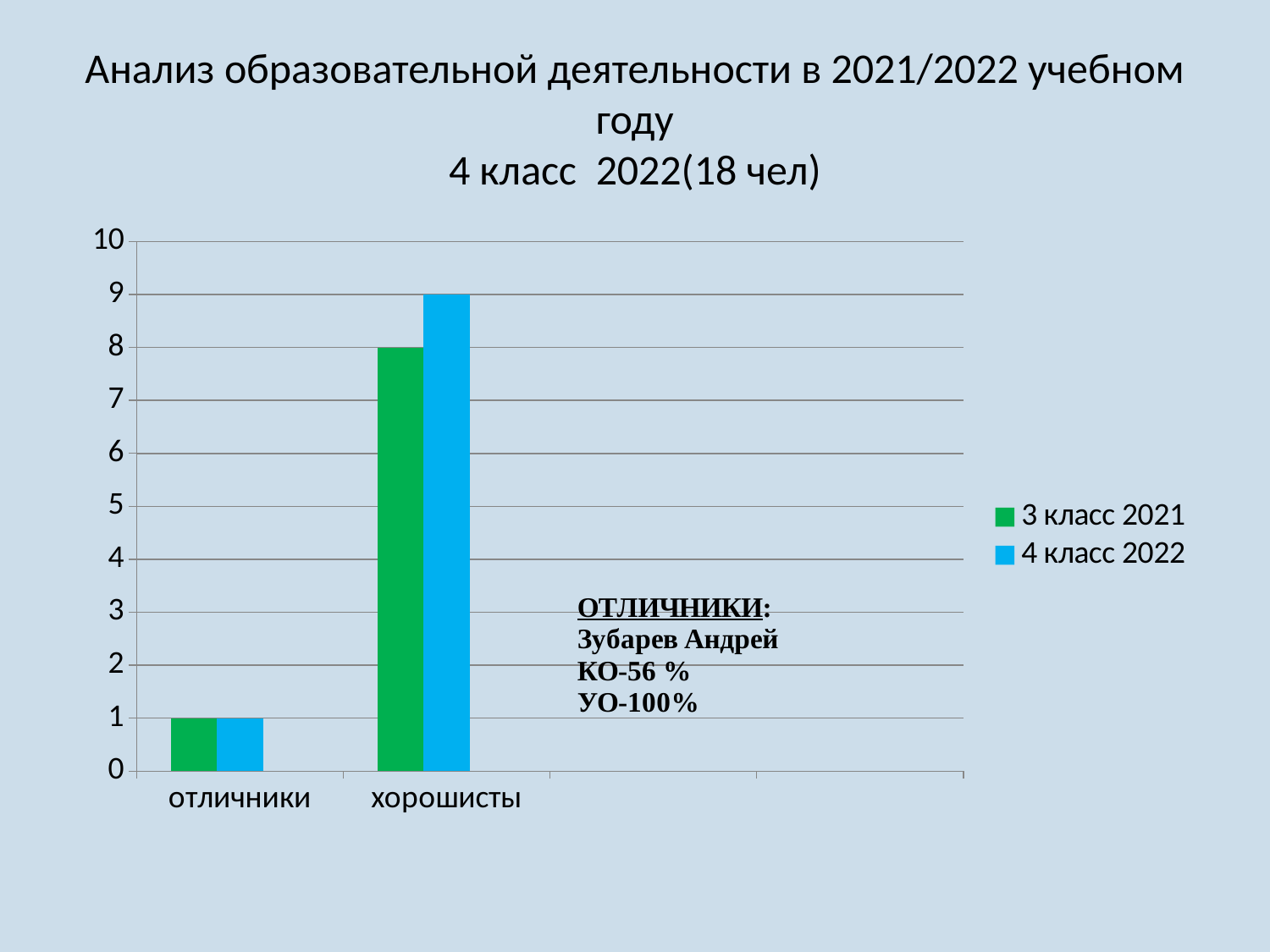
Which series is shown in green in the legend? 3 класс 2021 What is the value for отличники in the 4 класс 2022 series? 1 What is the difference between the 4 класс 2022 and 3 класс 2021 values for хорошисты? 1 What is the value for хорошисты in the 3 класс 2021 series? 8 For хорошисты, which series has the larger value, 3 класс 2021 or 4 класс 2022? 4 класс 2022 Which category has the lowest value in the 3 класс 2021 series? отличники Which category has the highest value in the 4 класс 2022 series? хорошисты How many categories are shown on the x axis? 2 What is the value for хорошисты in the 4 класс 2022 series? 9 What is the value for отличники in the 3 класс 2021 series? 1 What kind of chart is shown on the slide? bar chart How many series does the legend list? 2